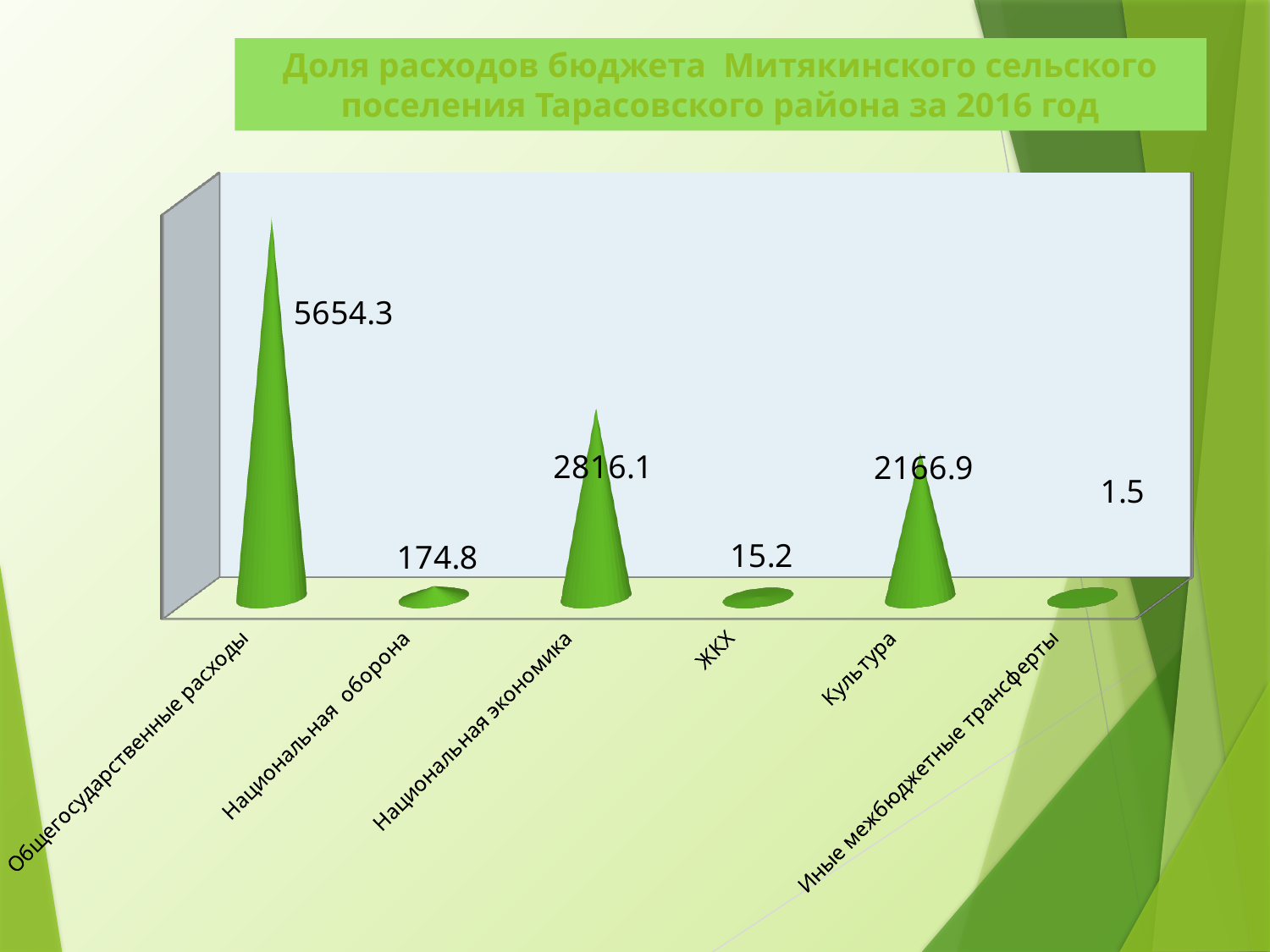
What is the value for Культура? 2166.9 What is the difference between the values for Национальная экономика and Культура? 649.2 What is the value for Общегосударственные расходы? 5654.3 Which category has the highest value? Общегосударственные расходы How many categories are shown on the chart? 6 Which is larger, the value for Национальная оборона or the value for ЖКХ? Национальная оборона What is the value for Иные межбюджетные трансферты? 1.5 What is the value for Национальная экономика? 2816.1 What is the value for ЖКХ? 15.2 What kind of chart is shown on the slide? Bar chart Which category has the lowest value? Иные межбюджетные трансферты What is the title of the chart? Доля расходов бюджета Митякинского сельского поселения Тарасовского района за 2016 год